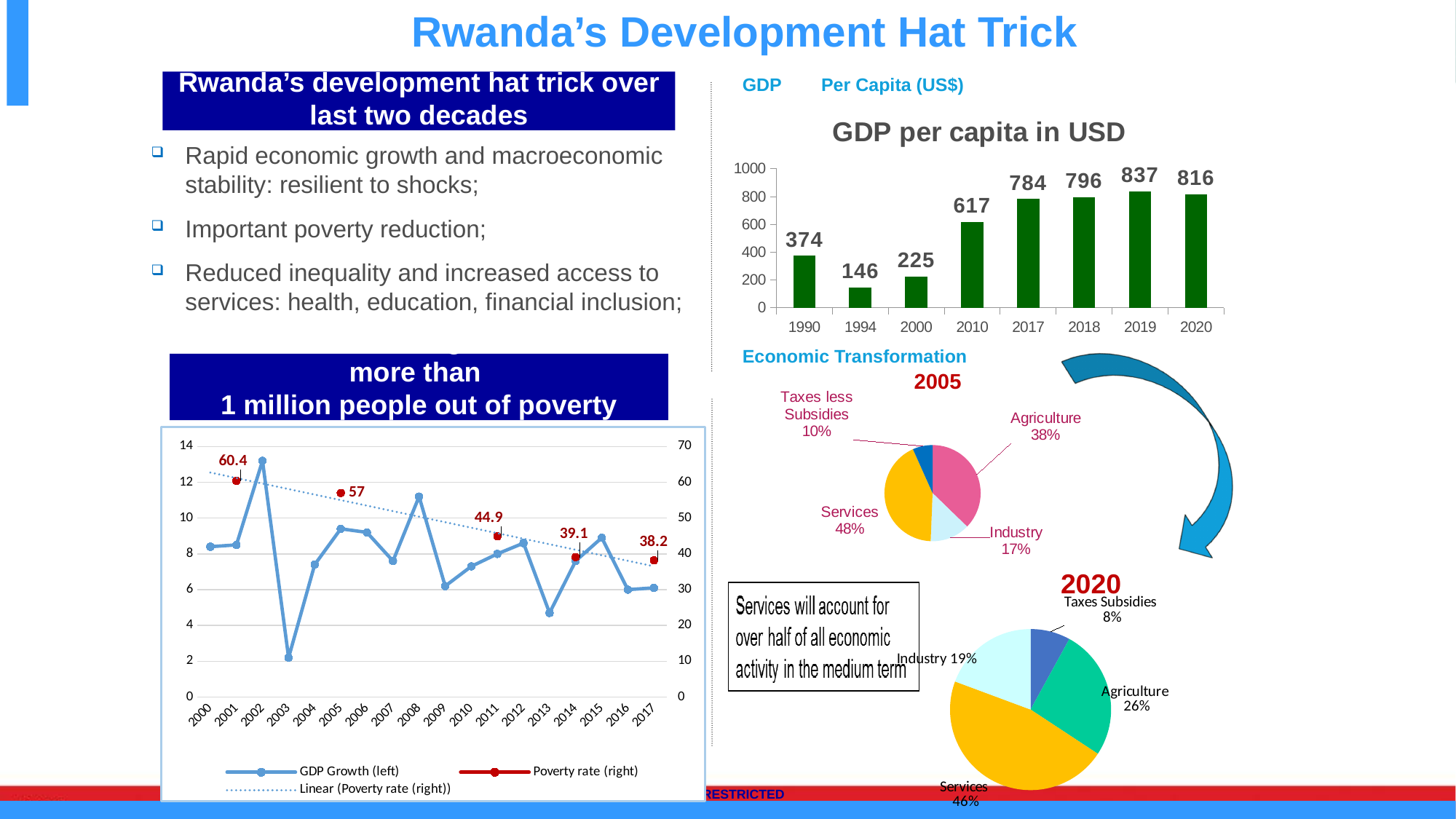
In the GDP per capita in USD chart, what is the difference between the 2020 value and the 1990 value? 442 In the GDP Growth and Poverty rate chart at the bottom left, is the GDP growth value for 2003 greater or less than 4? less How many years are shown in the GDP per capita in USD chart? 8 In the GDP Growth and Poverty rate chart at the bottom left, does the poverty rate rise or fall from 2001 to 2017? Fall In the GDP per capita in USD chart, which year has the lowest value? 1994 In the GDP Growth and Poverty rate chart at the bottom left, how many series does the legend list? 3 In the GDP per capita in USD chart, what is the value for 2010? 617 In the GDP per capita in USD chart, which year has the highest value? 2019 What kind of chart is the GDP per capita in USD chart? Bar chart In the 2020 pie chart, which is larger, Agriculture or Industry? Agriculture In the 2005 pie chart, what share does Services have? 48% In the GDP Growth and Poverty rate chart at the bottom left, what is the poverty rate labelled for 2011? 44.9